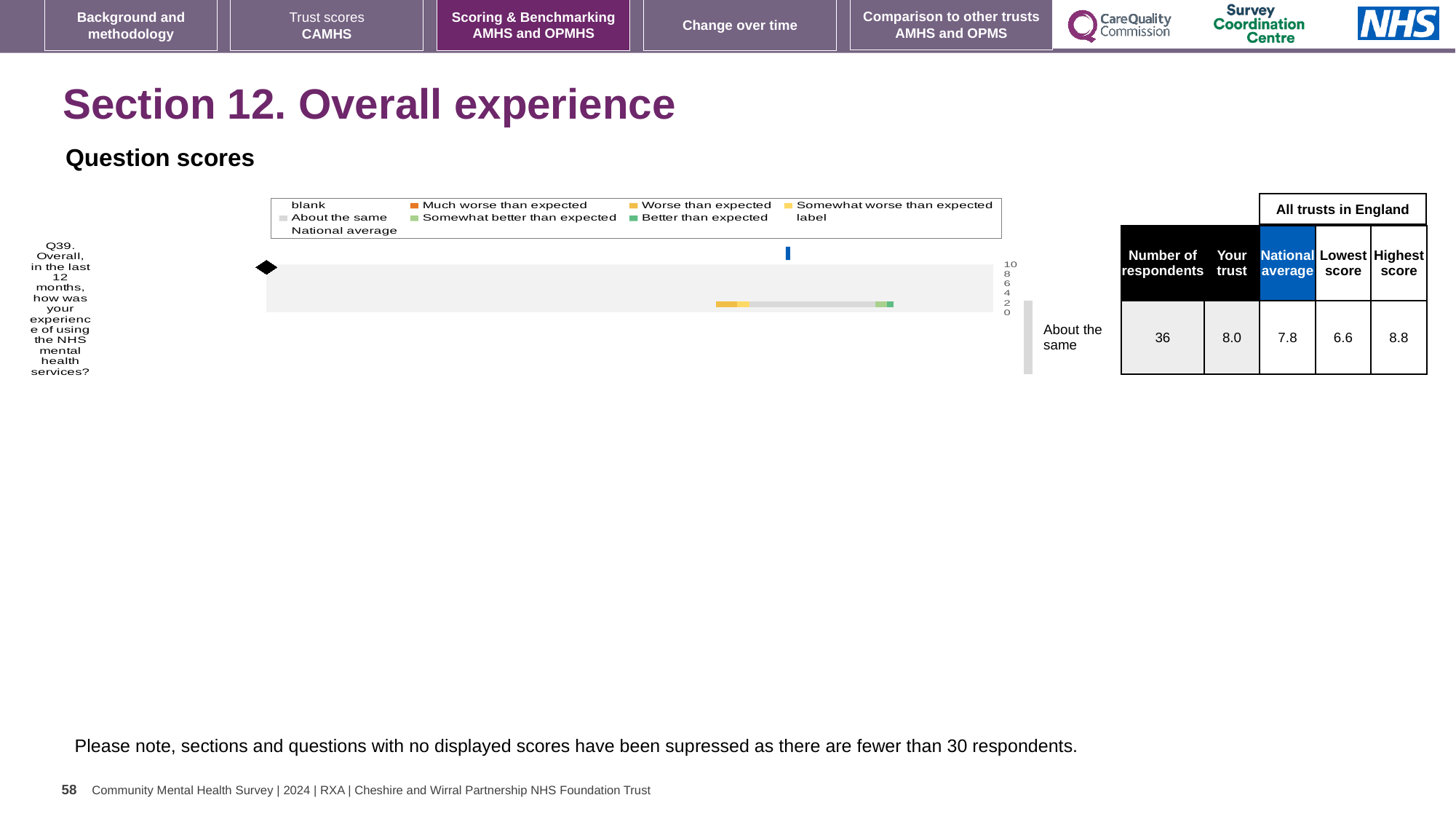
By how much does the 'Your trust' score for Q39 exceed the national average? 0.2 How many questions are plotted in the Question scores chart? 1 What is the 'Your trust' score for Q39 (Overall, in the last 12 months, how was your experience of using the NHS mental health services?)? 8.0 Which is larger for Q39: the 'Your trust' score or the national average? Your trust What is the national average score for Q39? 7.8 What is the highest score among all trusts in England for Q39? 8.8 How many respondents answered Q39? 36 What kind of chart is used to show the Q39 question score? bar chart What is the difference between the highest and lowest trust scores for Q39? 2.2 What is the lowest score among all trusts in England for Q39? 6.6 Which benchmarking category does the trust's Q39 score fall into? About the same What is the maximum value shown on the score axis of the Q39 chart? 10